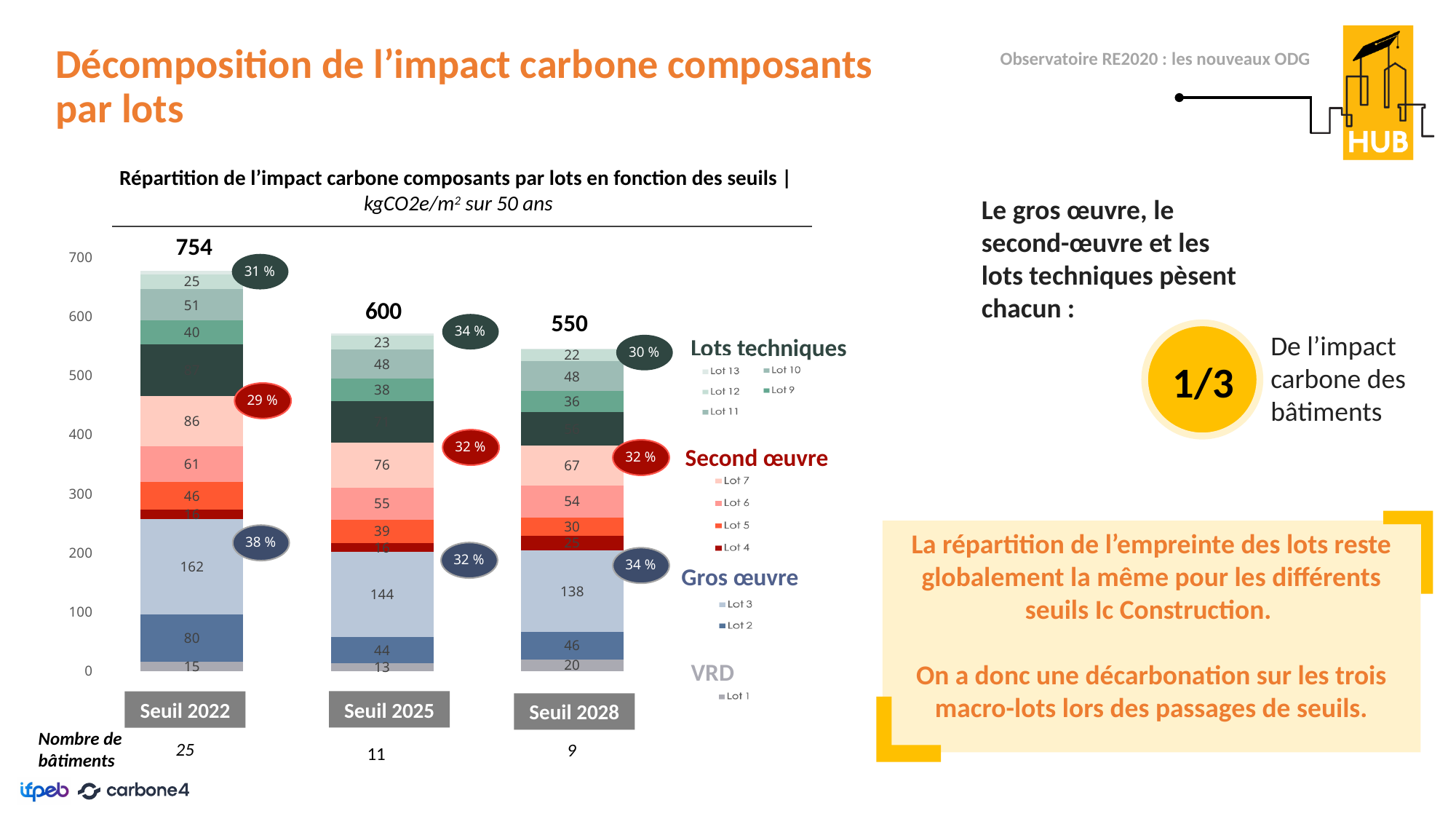
What is the value of Lot 1 for Seuil 2028? 20 What is the value of Lot 7 for Seuil 2028? 67 What is the value of Lot 3 for Seuil 2025? 144 What is the difference between the totals for Seuil 2022 and Seuil 2028? 204 How many lots does the legend list? 12 What percentage share does Gros œuvre represent for Seuil 2022? 38 % What kind of chart is shown on the slide? stacked bar chart Do the bar totals rise or fall from Seuil 2022 to Seuil 2028? fall Which seuil has the highest total impact carbone? Seuil 2022 How many bars (seuils) are plotted in the chart? 3 Which is larger: Lot 2 for Seuil 2022 or Lot 2 for Seuil 2025? Seuil 2022 What is the total value printed above the Seuil 2022 bar? 754